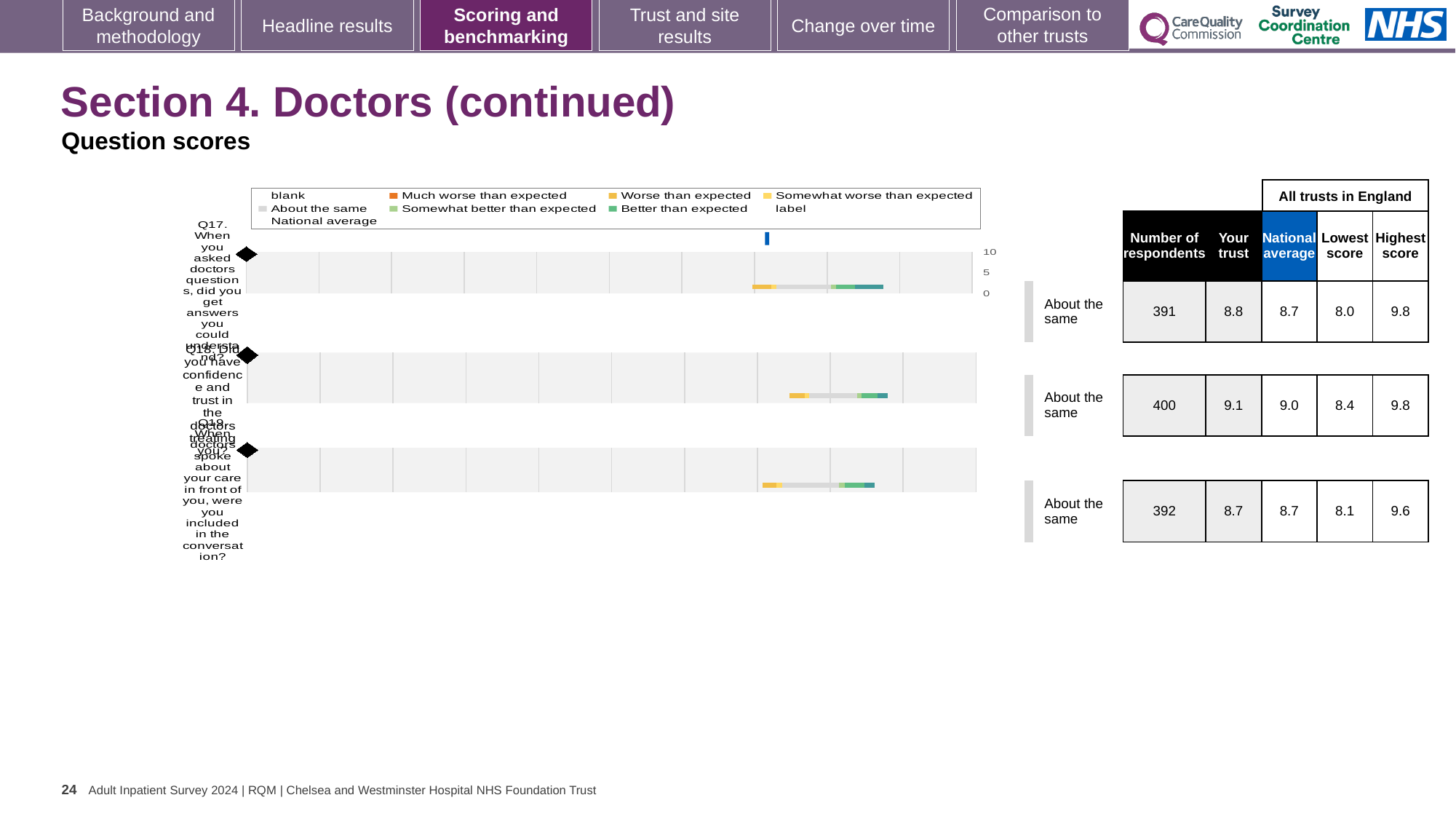
Which question has the lowest 'Your trust' score in the table beside the chart? Q19 How many respondents are listed for Q19 in the table beside the chart? 392 What kind of chart is shown on the slide? bar chart For Q18, what is the difference between the highest score and the lowest score in the table beside the chart? 1.4 What colour does the legend use for 'Much worse than expected'? orange How many questions (categories) are plotted in the chart? 3 Which question has the highest 'Your trust' score in the table beside the chart? Q18 What is the highest tick value shown on the chart's axis? 10 How many entries does the chart's legend list? 9 What is the 'Your trust' score for Q18 shown in the table beside the chart? 9.1 For Q17, which is larger in the table beside the chart: the 'Your trust' score or the national average? Your trust What is the national average score for Q17 shown in the table beside the chart? 8.7